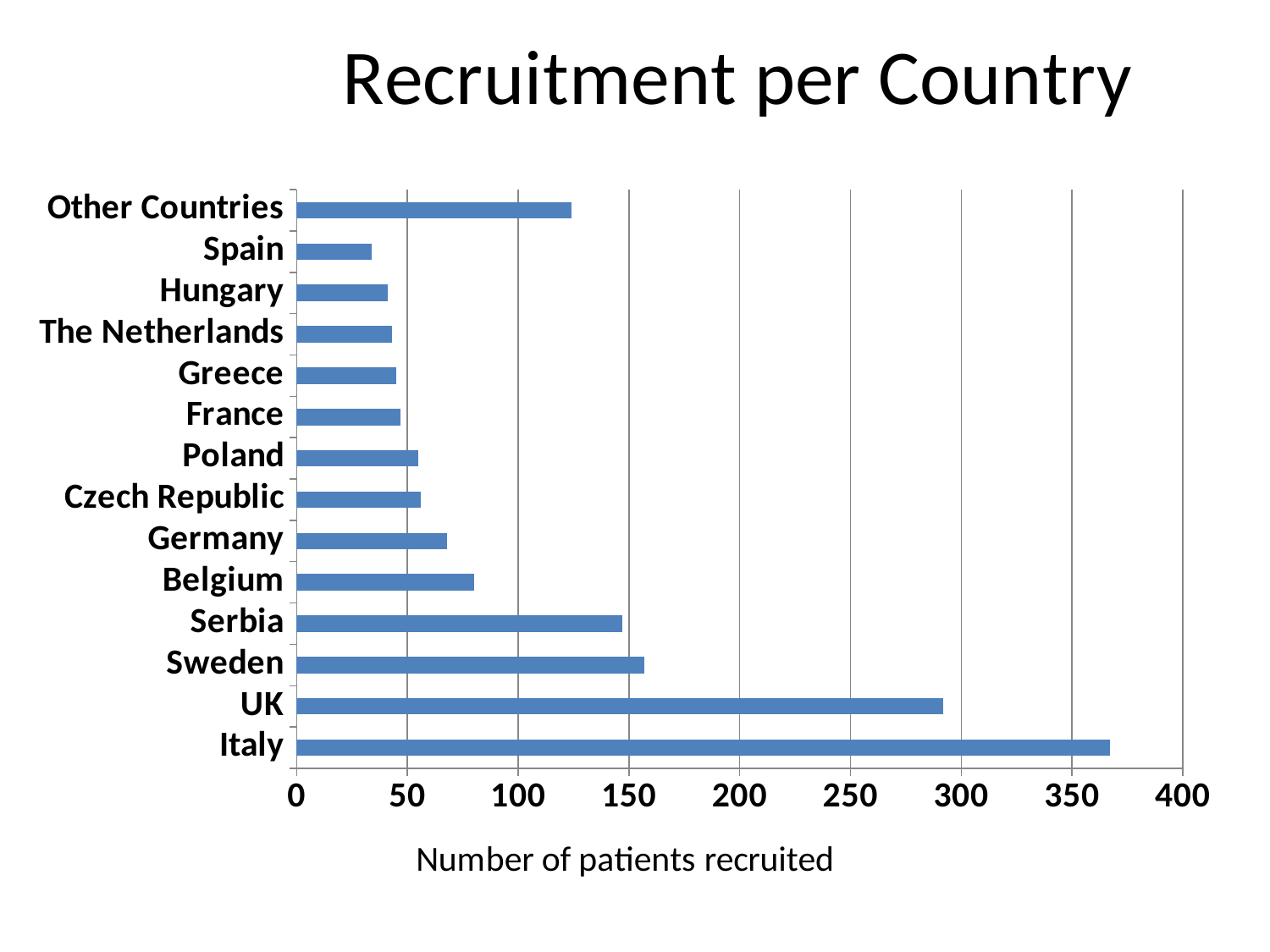
Is the value for Other Countries greater or less than 100? greater Is the value for Italy greater or less than 350? greater Which has more patients recruited, UK or Sweden? UK Is the value for Germany greater or less than 100? less What is the label of the horizontal axis? Number of patients recruited Which country has the highest number of patients recruited? Italy Which has more patients recruited, Serbia or Other Countries? Serbia How many categories are shown on the chart? 14 Which country has the lowest number of patients recruited? Spain What kind of chart is shown on the slide? bar chart